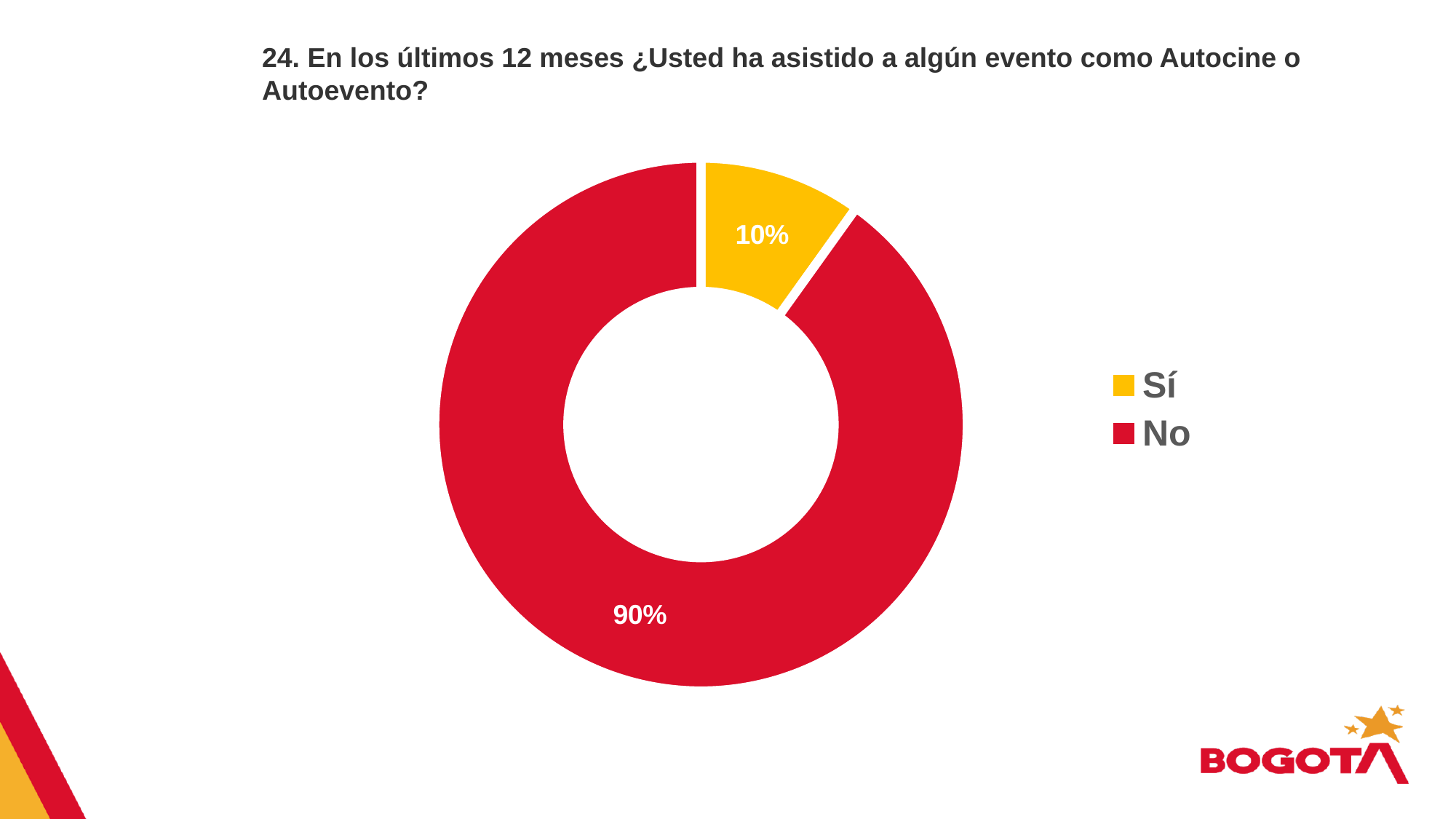
What colour is the "Sí" slice? Yellow What share of the chart does the "No" slice represent? 90% What percentage of respondents answered "No"? 90% What colour is the "No" slice? Red What is the difference in percentage points between the "No" and "Sí" shares? 80 Which is larger, the share for "Sí" or the share for "No"? No What kind of chart is shown on the slide? Doughnut (pie) chart Which response has the largest share of the chart? No Which response has the smallest share of the chart? Sí How many categories does the chart show? 2 How many entries does the legend list? 2 What percentage of respondents answered "Sí"? 10%